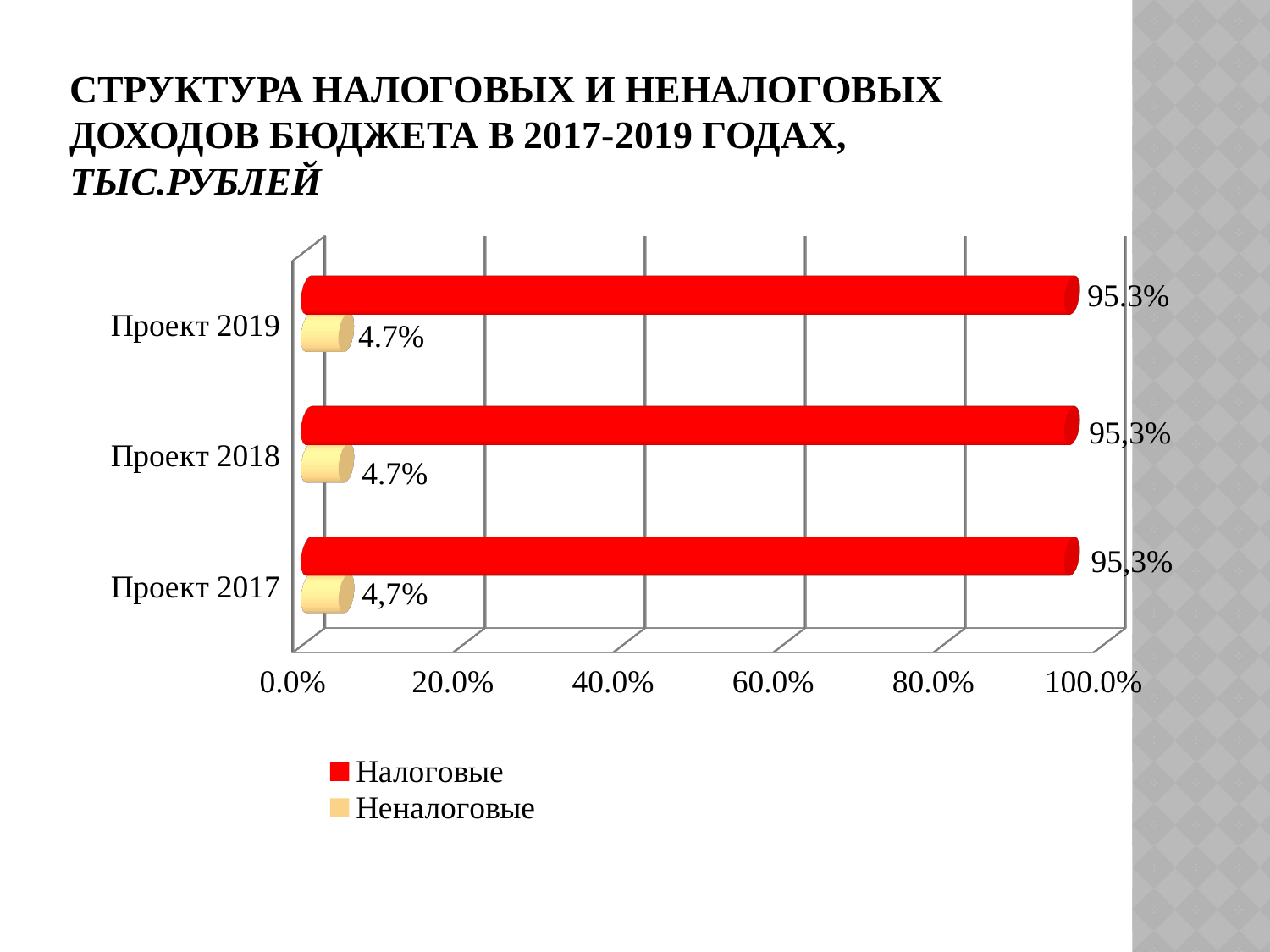
Is the value for Налоговые in Проект 2019 greater or less than 80.0%? greater How many series does the legend list? 2 How many categories are shown on the chart? 3 What kind of chart is shown on the slide? Bar chart Is the value for Неналоговые in Проект 2017 greater or less than 20.0%? less What is the value for Налоговые in Проект 2017? 95,3% What is the value for Налоговые in Проект 2019? 95,3% Which series has the larger value in Проект 2018, Налоговые or Неналоговые? Налоговые Which colour represents the Неналоговые series in the legend? Yellow Does the value for Налоговые change from Проект 2017 to Проект 2019? No, it stays at 95,3% What is the value for Неналоговые in Проект 2017? 4,7% What is the value for Неналоговые in Проект 2018? 4.7%